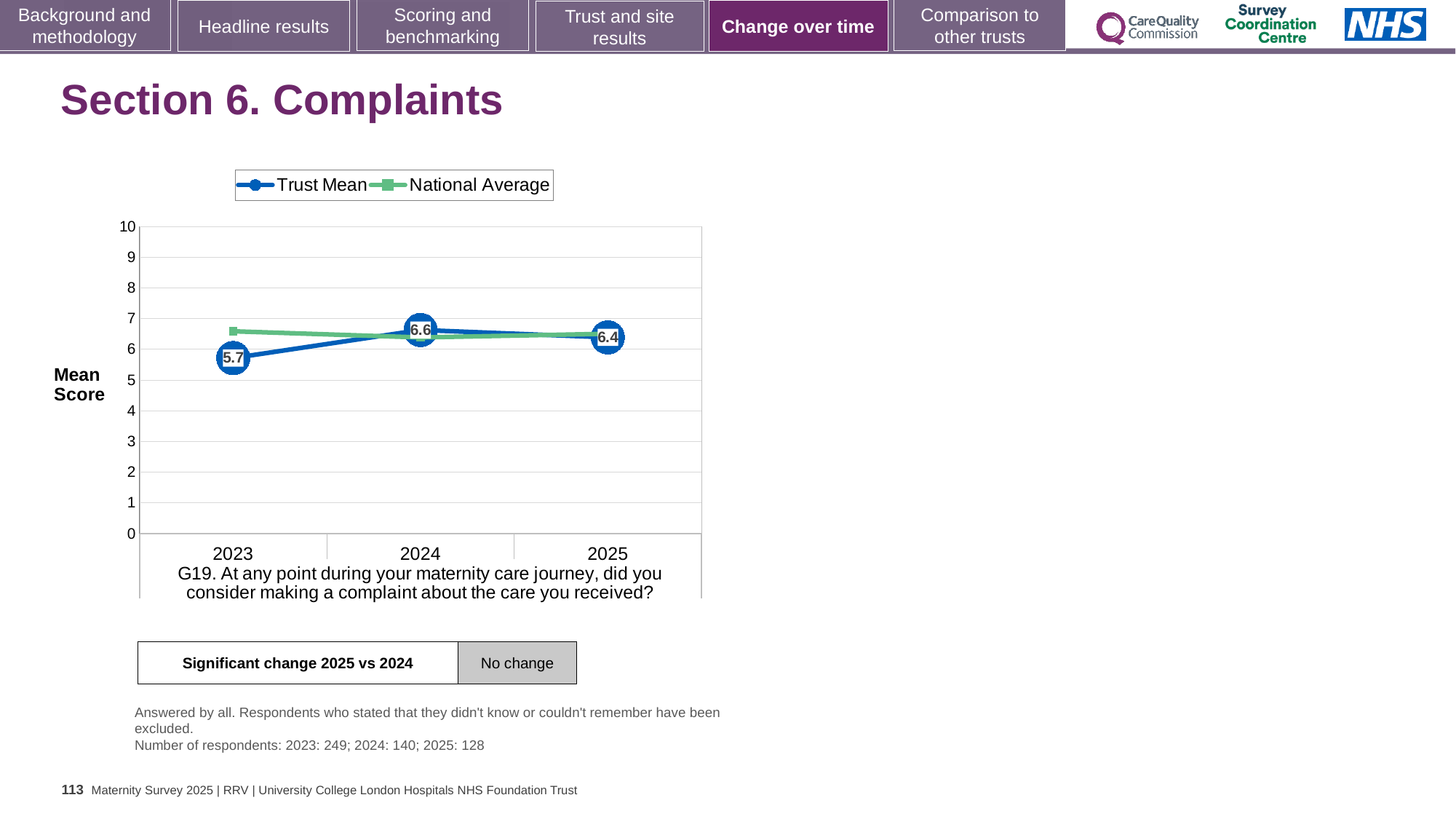
What is the Trust Mean score for 2025? 6.4 In which year is the Trust Mean score highest? 2024 What is the Trust Mean score for 2024? 6.6 What is the difference between the Trust Mean scores for 2024 and 2023? 0.9 In 2023, which is higher, the Trust Mean or the National Average? National Average What kind of chart is shown on the slide? line chart In which year is the Trust Mean score lowest? 2023 Which year has the larger Trust Mean score, 2023 or 2025? 2025 How many years are shown on the x axis of the chart? 3 What is the Trust Mean score for 2023? 5.7 Is the National Average value for 2023 greater or less than 6? greater How many series does the chart legend list? 2